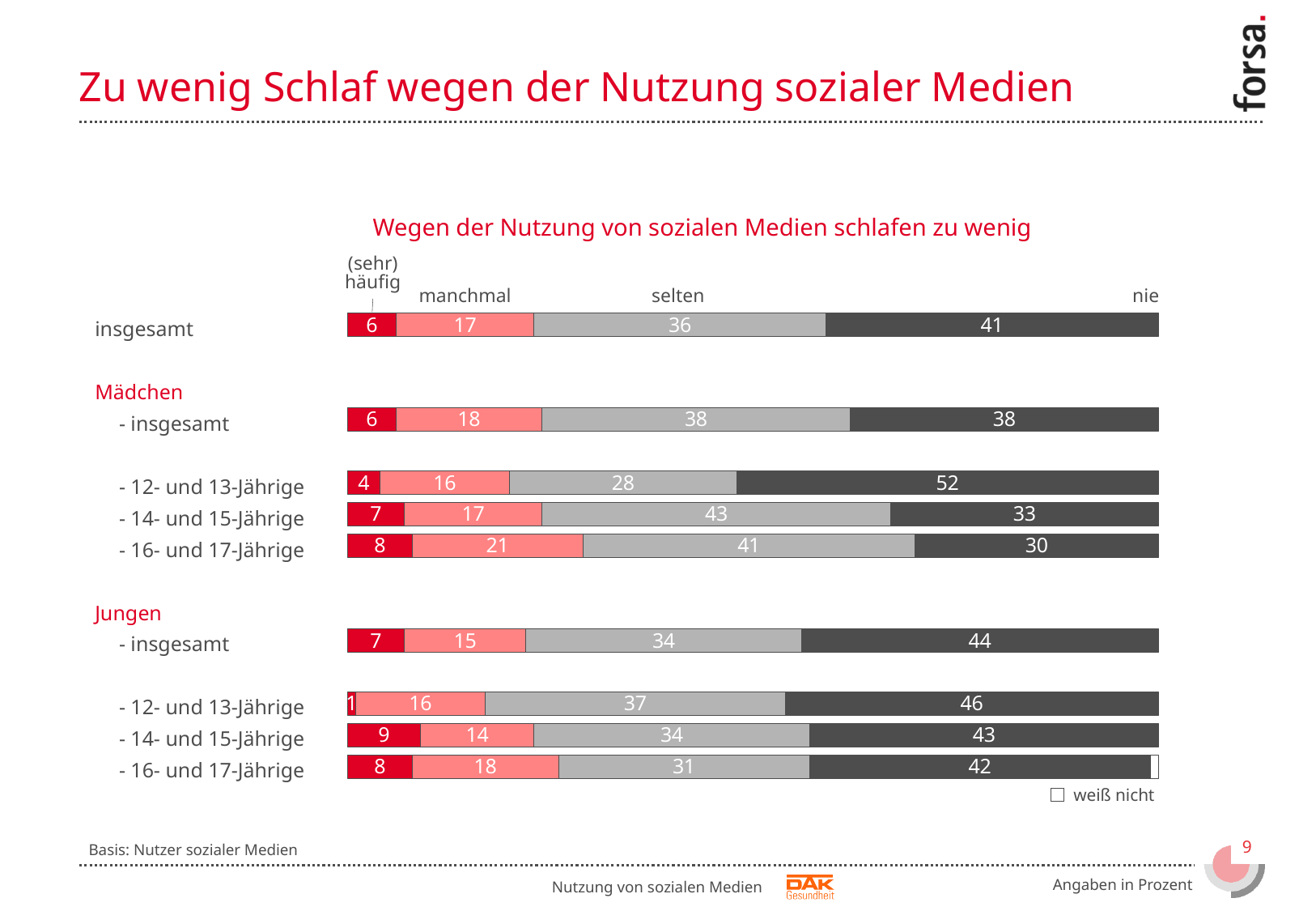
What percentage of all respondents (insgesamt) answered "nie"? 41 What is the sum of the "(sehr) häufig" and "manchmal" values for Mädchen aged 16 and 17 (16- und 17-Jährige)? 29 How many groups (bars) are shown in the chart? 9 Which group has the highest "nie" value? Mädchen, 12- und 13-Jährige What is the "(sehr) häufig" value for Jungen aged 12 and 13 (12- und 13-Jährige)? 1 What is the difference between the "manchmal" values for Mädchen insgesamt and Jungen insgesamt? 3 Which is larger: the "nie" value for Mädchen insgesamt or for Jungen insgesamt? Jungen insgesamt What is the "selten" value for Mädchen aged 14 and 15 (14- und 15-Jährige)? 43 What type of chart is shown on the slide? Stacked bar chart Which group has the lowest "(sehr) häufig" value? Jungen, 12- und 13-Jährige What is the title of the chart? Wegen der Nutzung von sozialen Medien schlafen zu wenig How many response categories are labelled above the bars (excluding "weiß nicht")? 4